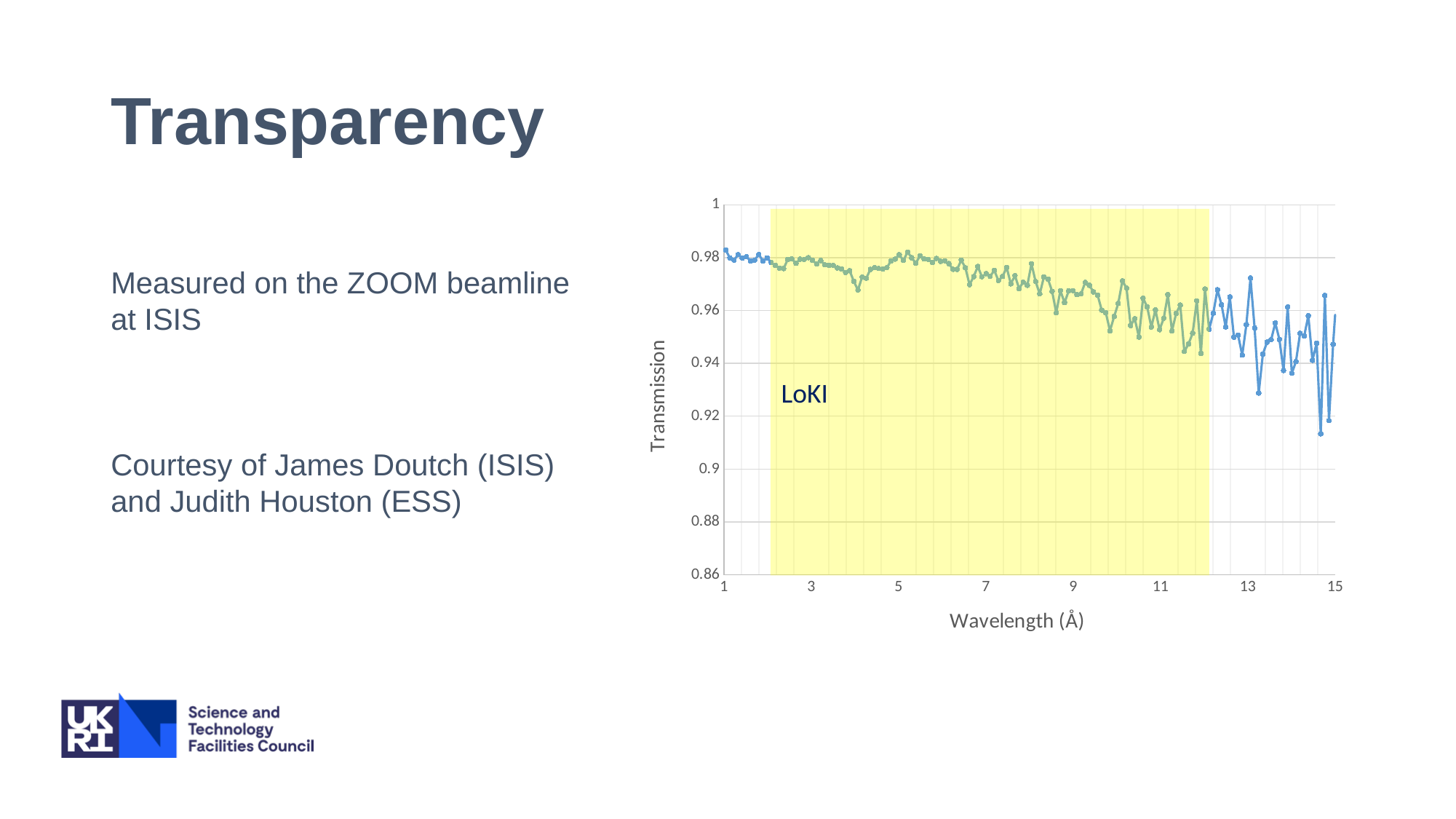
Is the transmission at a wavelength of 5 Å greater or less than 0.96? greater Which has the higher transmission: the point at 5 Å or the point at 13 Å? 5 Å What label appears inside the yellow shaded region of the chart? LoKI Is the lowest transmission value plotted greater or less than 0.9? greater Is the transmission at a wavelength of 13 Å greater or less than 0.98? less Do the transmission values generally rise or fall as wavelength increases from 1 to 15 Å? fall Is the transmission at a wavelength of 1 Å greater or less than 0.96? greater What is the label on the vertical axis of the chart? Transmission What kind of chart is shown on the slide? line chart